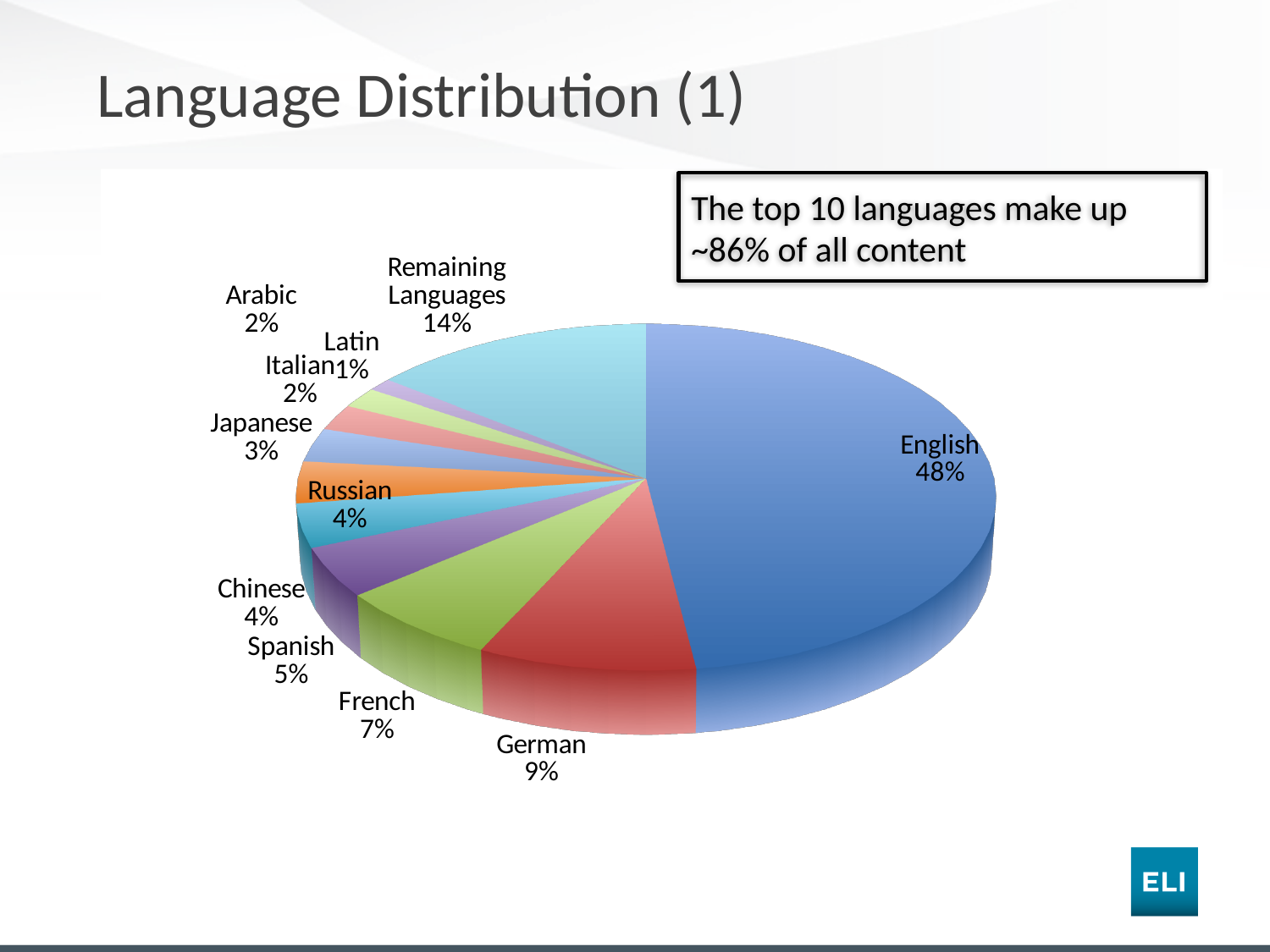
What share of content is French? 7% What kind of chart is shown on the slide? pie chart How many slices does the pie chart have? 11 What share of content is Latin? 1% Which slice of the pie is the smallest? Latin What is the difference in percentage points between English and German? 39 Which is larger, the share for Spanish or the share for Japanese? Spanish What share of content is English? 48% What share of content is German? 9% What share of content is labelled Remaining Languages? 14% Which language has the largest slice of the pie? English What is the title of the slide containing the pie chart? Language Distribution (1)